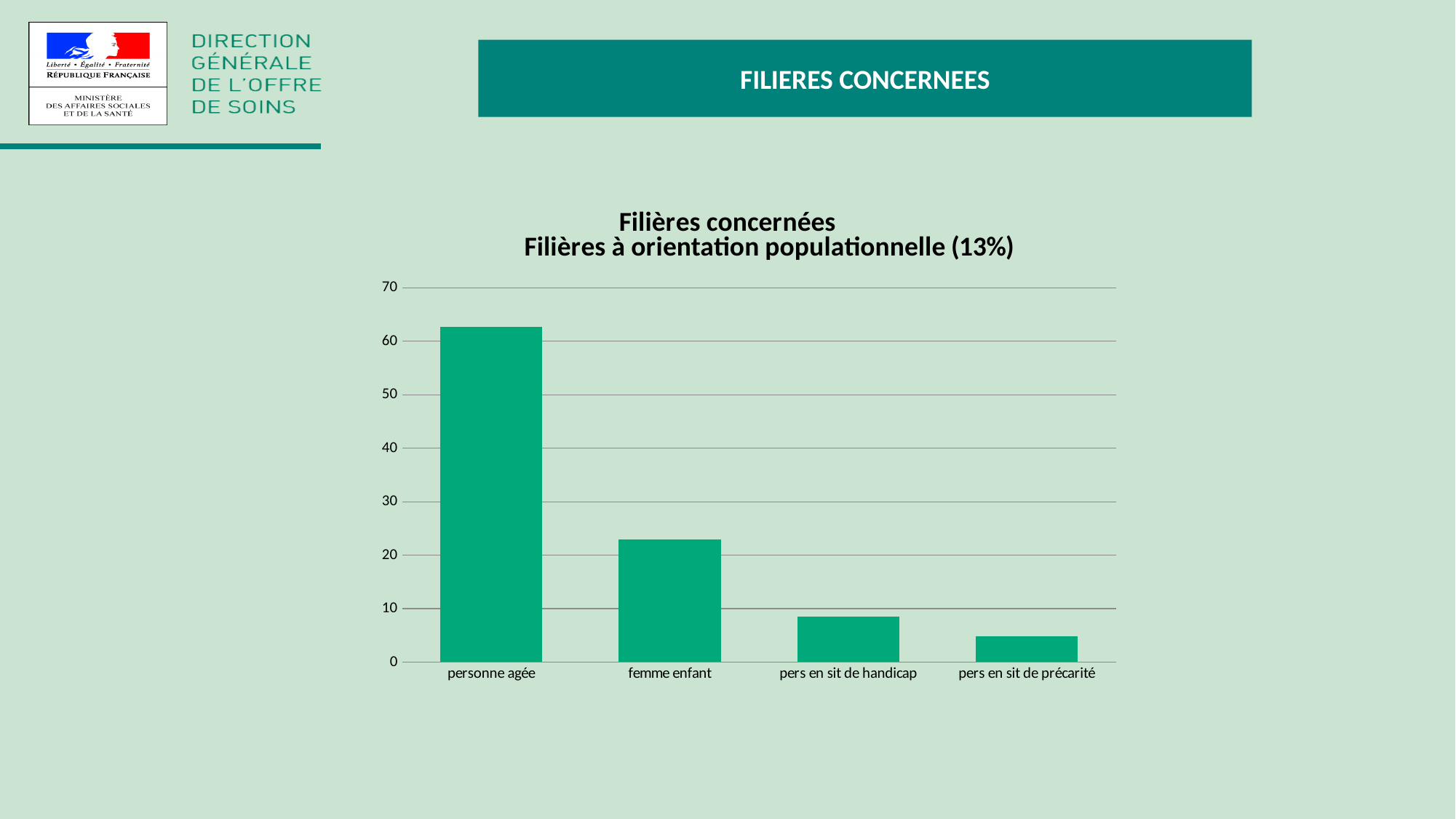
Is the value for femme enfant greater or less than 20? greater Is the value for personne agée greater or less than 60? greater Do the values rise or fall from left to right along the x axis? fall What is the second line of the chart title? Filières à orientation populationnelle (13%) Which category has the highest value in the chart? personne agée Is the value for pers en sit de handicap greater or less than 10? less What kind of chart is shown on the slide? bar chart Which category has the lowest value in the chart? pers en sit de précarité How many categories are shown on the x axis of the chart? 4 Which is larger, the value for femme enfant or the value for pers en sit de handicap? femme enfant What is the highest value shown on the vertical axis of the chart? 70